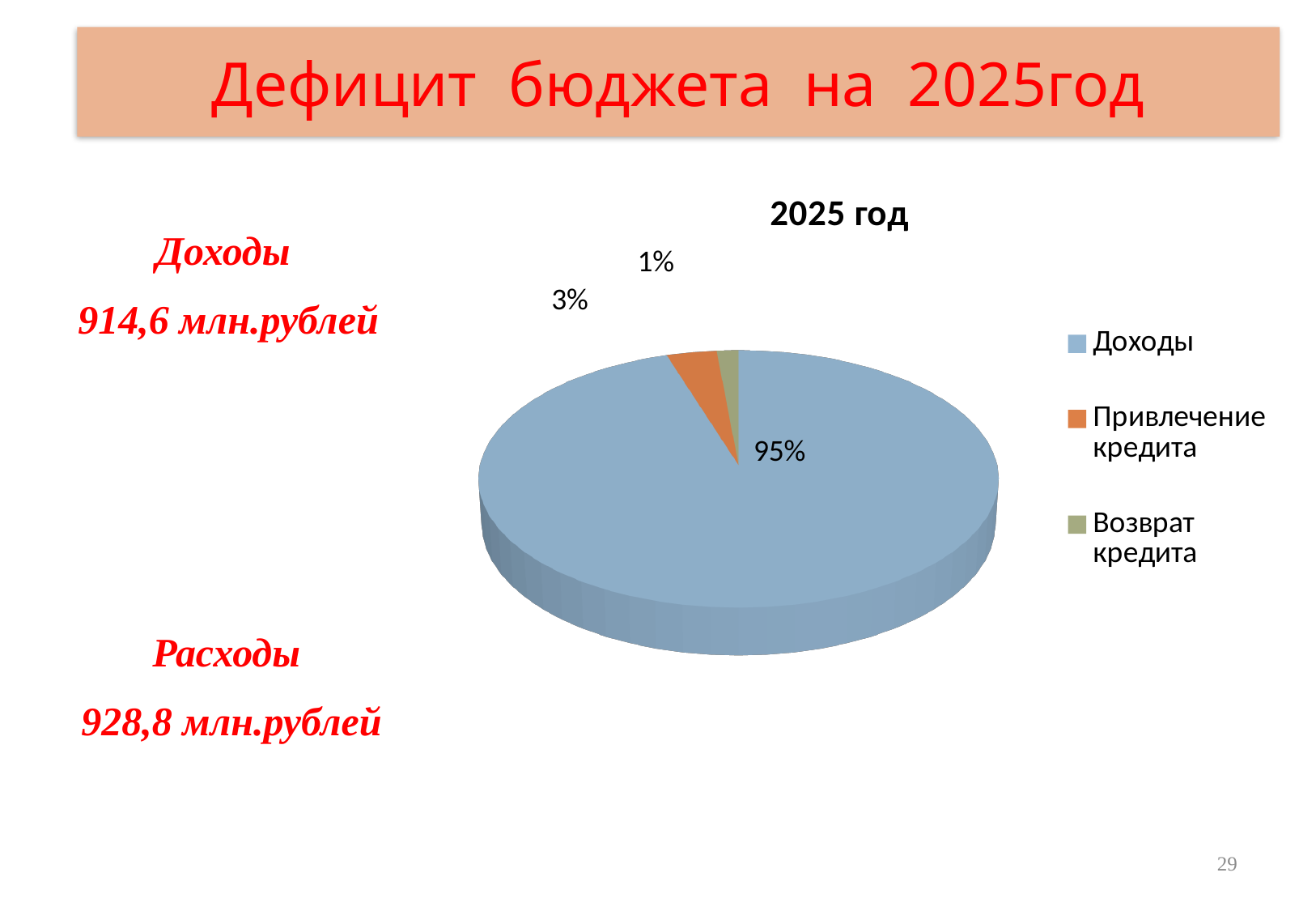
What is the difference in percentage points between the Доходы slice and the Привлечение кредита slice? 92 What share of the pie does Доходы represent? 95% What colour is the Привлечение кредита slice? Orange What share of the pie does Возврат кредита represent? 1% What type of chart is shown on the slide? Pie chart Which slice is larger, Привлечение кредита or Возврат кредита? Привлечение кредита What share of the pie does Привлечение кредита represent? 3% Which category has the largest slice of the pie? Доходы What is the title of the chart? 2025 год How many slices does the pie chart have? 3 Which category has the smallest slice of the pie? Возврат кредита How many entries does the legend list? 3